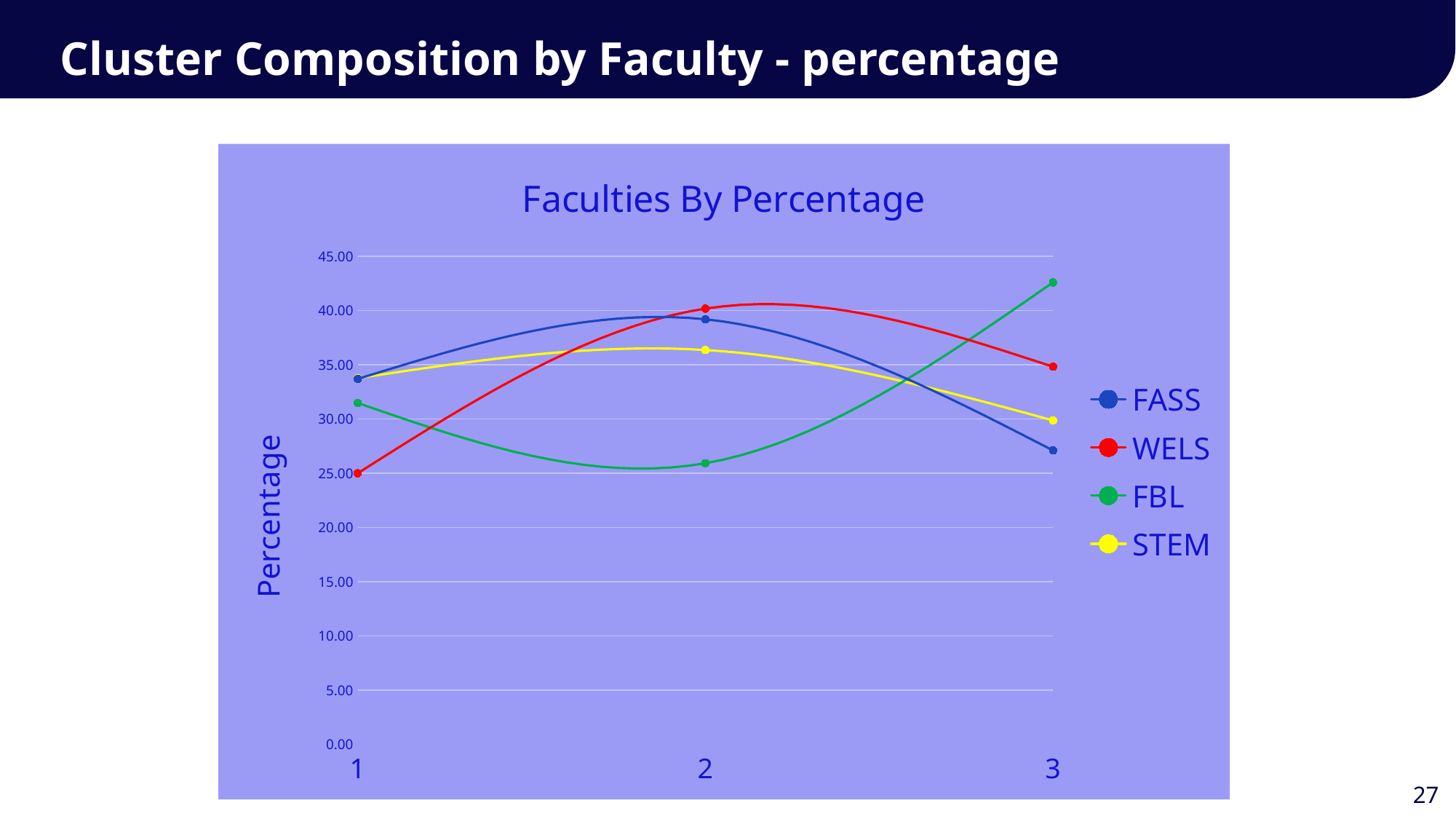
Which is larger at cluster 1, FASS or FBL? FASS How many clusters are plotted along the x axis? 3 Which faculty has the lowest percentage at cluster 3? FASS Is the value for FBL at cluster 3 greater or less than 40.00? greater What is the title of the chart? Faculties By Percentage Does the FBL line rise or fall from cluster 2 to cluster 3? rise Is the value for FASS at cluster 3 greater or less than 30.00? less Which faculty has the highest percentage at cluster 3? FBL Which faculty has the lowest percentage at cluster 1? WELS How many series does the legend list? 4 Which faculty has the lowest percentage at cluster 2? FBL What kind of chart is shown on the slide? line chart